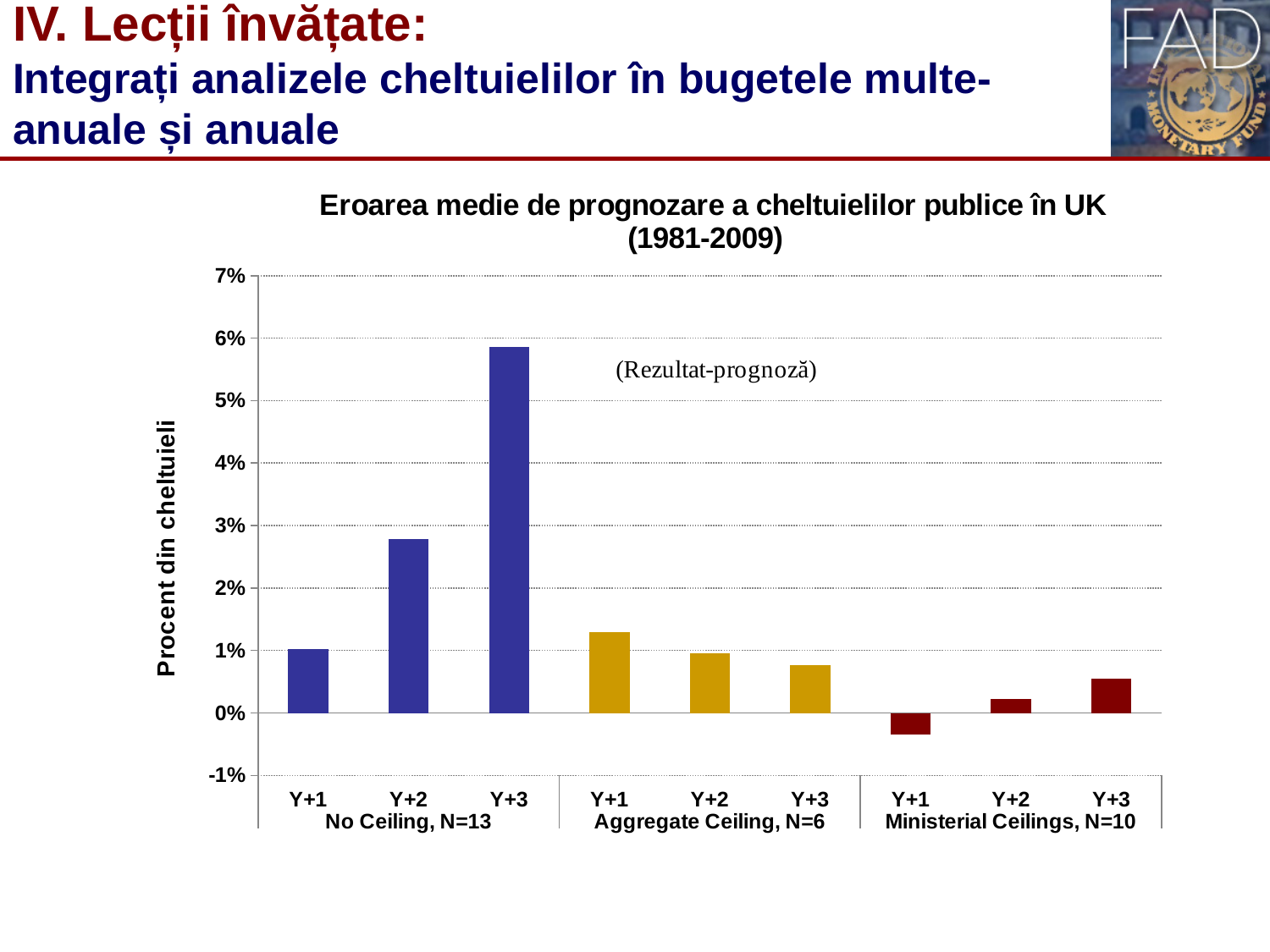
Is the value for Y+1 in the Ministerial Ceilings, N=10 group greater or less than 0%? less Within the No Ceiling, N=13 group, do the values rise or fall from Y+1 to Y+3? rise Which is larger: the Y+2 value in the No Ceiling, N=13 group or the Y+2 value in the Aggregate Ceiling, N=6 group? No Ceiling, N=13 How many bars are plotted in the chart? 9 Which bar has the highest value in the chart? Y+3 in No Ceiling, N=13 Is the value for Y+2 in the No Ceiling, N=13 group greater or less than 2%? greater Is the value for Y+3 in the Aggregate Ceiling, N=6 group greater or less than 1%? less What is the label of the vertical axis? Procent din cheltuieli What kind of chart is shown on the slide? bar chart Which bar has the lowest value in the chart? Y+1 in Ministerial Ceilings, N=10 What is the title of the chart? Eroarea medie de prognozare a cheltuielilor publice în UK (1981-2009)